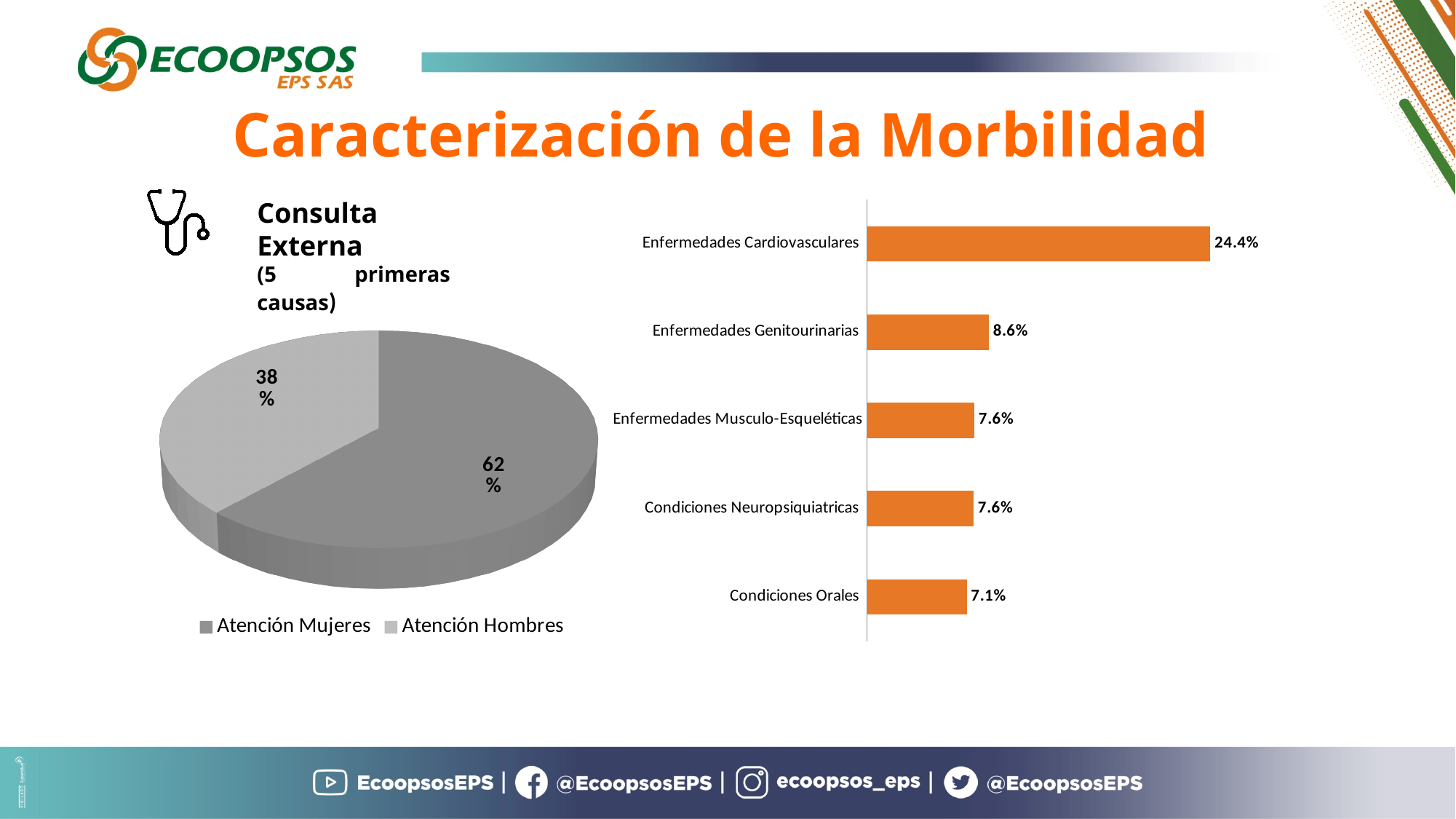
In the bar chart on the right, what is the value for Enfermedades Cardiovasculares? 24.4% In the bar chart on the right, what is the value for Condiciones Orales? 7.1% In the bar chart on the right, what is the difference between Enfermedades Cardiovasculares and Enfermedades Genitourinarias? 15.8% In the pie chart on the left, how many entries does the legend list? 2 In the pie chart on the left, what share is labelled for Atención Mujeres? 62% In the pie chart on the left, which slice is larger, Atención Mujeres or Atención Hombres? Atención Mujeres What kind of chart is the chart on the left of the slide? Pie chart In the bar chart on the right, which category has the highest value? Enfermedades Cardiovasculares In the pie chart on the left, what share is labelled for Atención Hombres? 38% What kind of chart is the chart on the right of the slide? Bar chart In the bar chart on the right, which category has the lowest value? Condiciones Orales In the bar chart on the right, what is the value for Enfermedades Genitourinarias? 8.6%